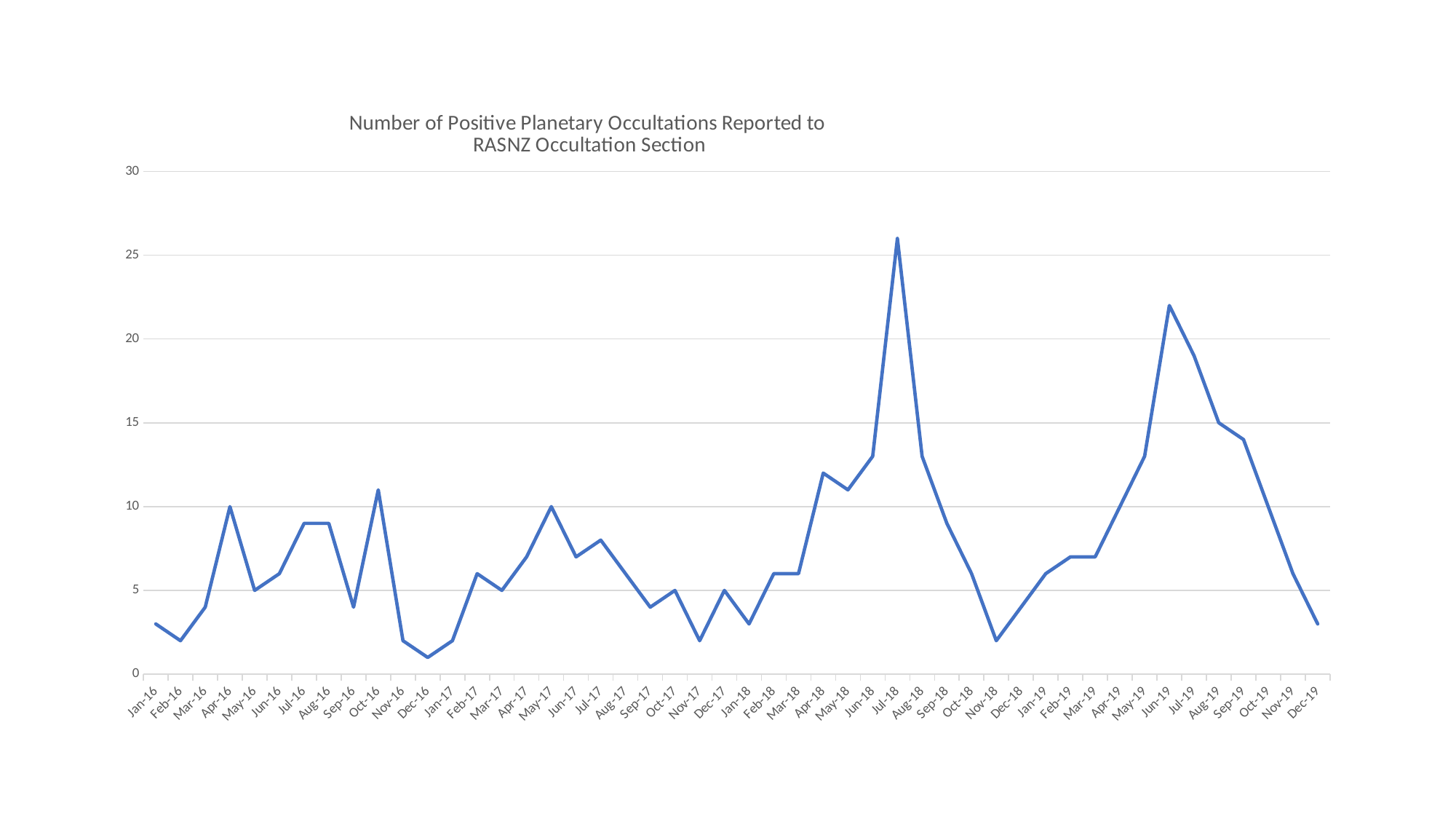
Is the value for Jun-19 greater or less than 20? greater How many months are plotted on the x axis? 48 Which month has the lowest number of positive planetary occultations reported? Dec-16 What type of chart is shown on the slide? Line chart Is the value for Jul-18 greater or less than 25? greater Is the value for Nov-18 greater or less than 5? less Which month has the highest number of positive planetary occultations reported? Jul-18 What is the value for Aug-19? 15 What is the value for Apr-16? 10 Which is larger, the value for Jul-18 or the value for Jun-19? Jul-18 What is the title of the chart? Number of Positive Planetary Occultations Reported to RASNZ Occultation Section